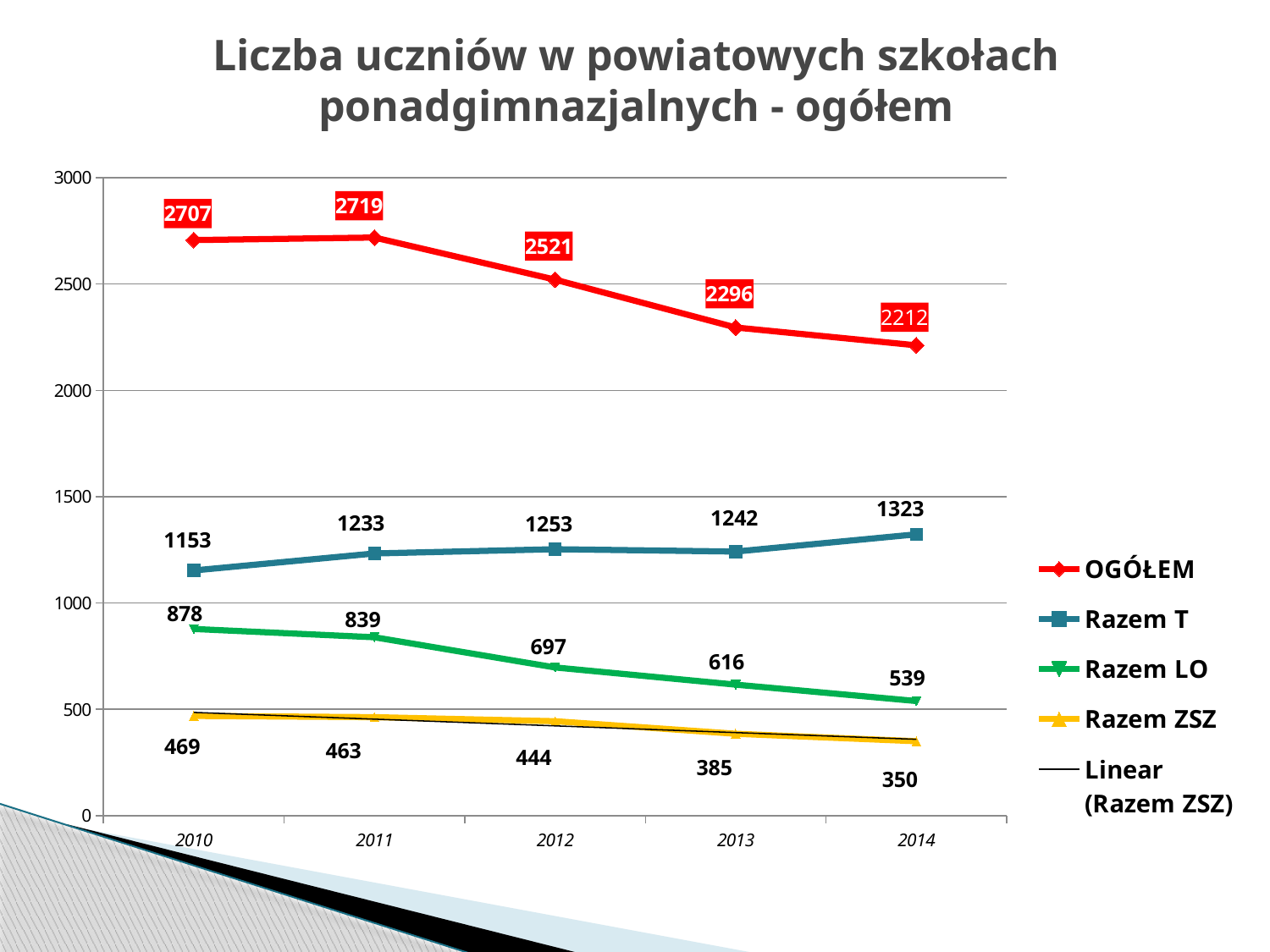
What kind of chart is this? line chart Which is larger in 2014: Razem T or Razem LO? Razem T How many years are shown on the x axis? 5 What is the value of Razem LO in 2013? 616 What is the value of Razem T in 2012? 1253 Does Razem LO rise or fall from 2010 to 2014? fall What is the value of OGÓŁEM in 2014? 2212 How many entries does the legend list? 5 In which year is OGÓŁEM highest? 2011 What is the value of Razem ZSZ in 2010? 469 In which year is Razem ZSZ lowest? 2014 What is the difference between OGÓŁEM in 2010 and in 2014? 495